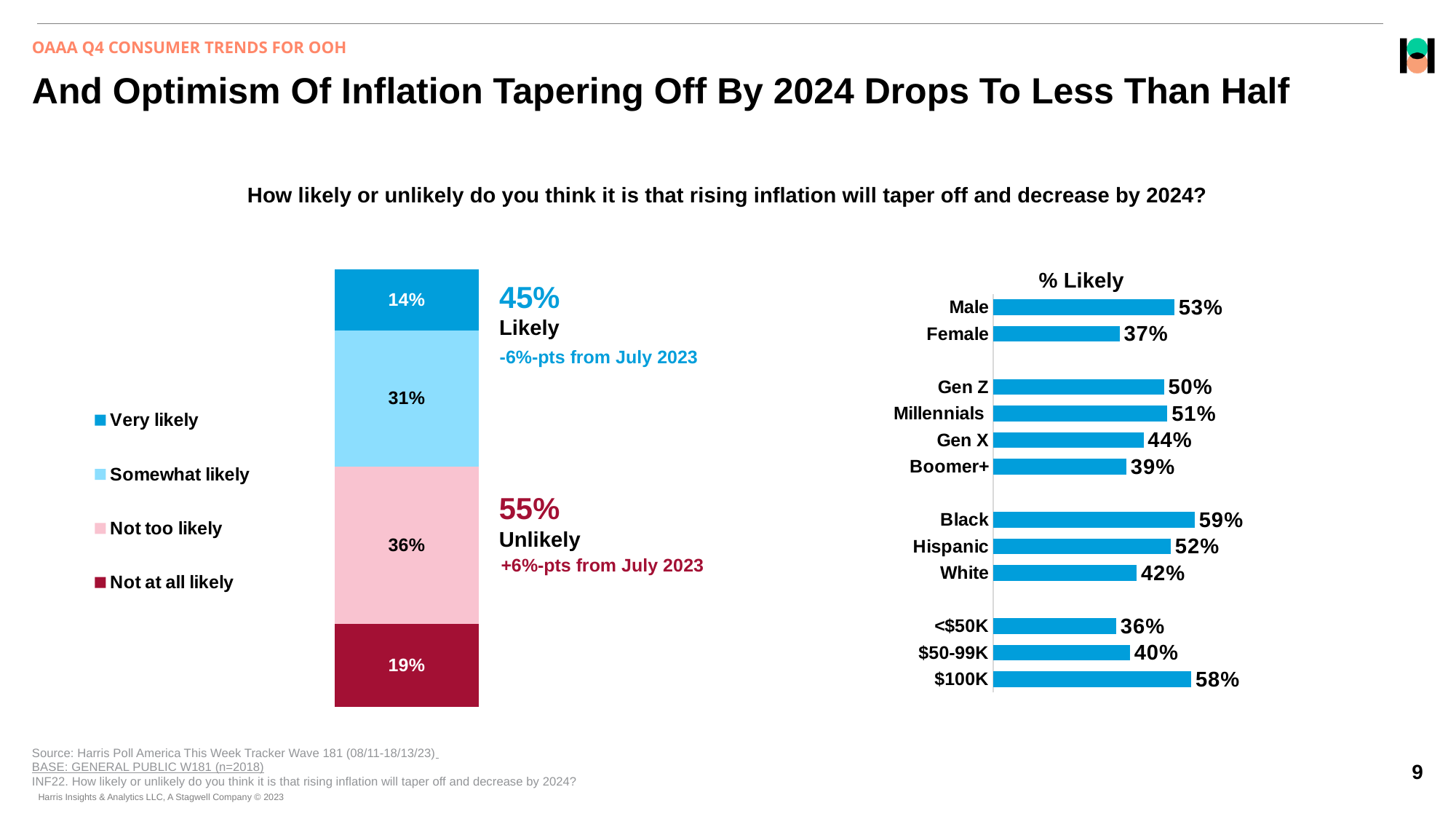
In the stacked bar chart on the left, what percentage is shown for 'Not at all likely'? 19% In the '% Likely' chart on the right, which category has the lowest value? <$50K In the stacked bar chart on the left, what percentage is shown for 'Somewhat likely'? 31% In the '% Likely' chart on the right, which category has the highest value? Black In the '% Likely' chart on the right, which is larger, Hispanic or White? Hispanic In the stacked bar chart on the left, how many entries does the legend list? 4 In the stacked bar chart on the left, which segment is the largest? Not too likely In the '% Likely' chart on the right, what is the difference between Male and Female? 16% In the '% Likely' chart on the right, what is the value for Gen X? 44% In the stacked bar chart on the left, what is the combined total of the 'Very likely' and 'Somewhat likely' segments? 45% In the '% Likely' chart on the right, what is the value for Female? 37% In the '% Likely' chart on the right, how many categories are plotted? 12